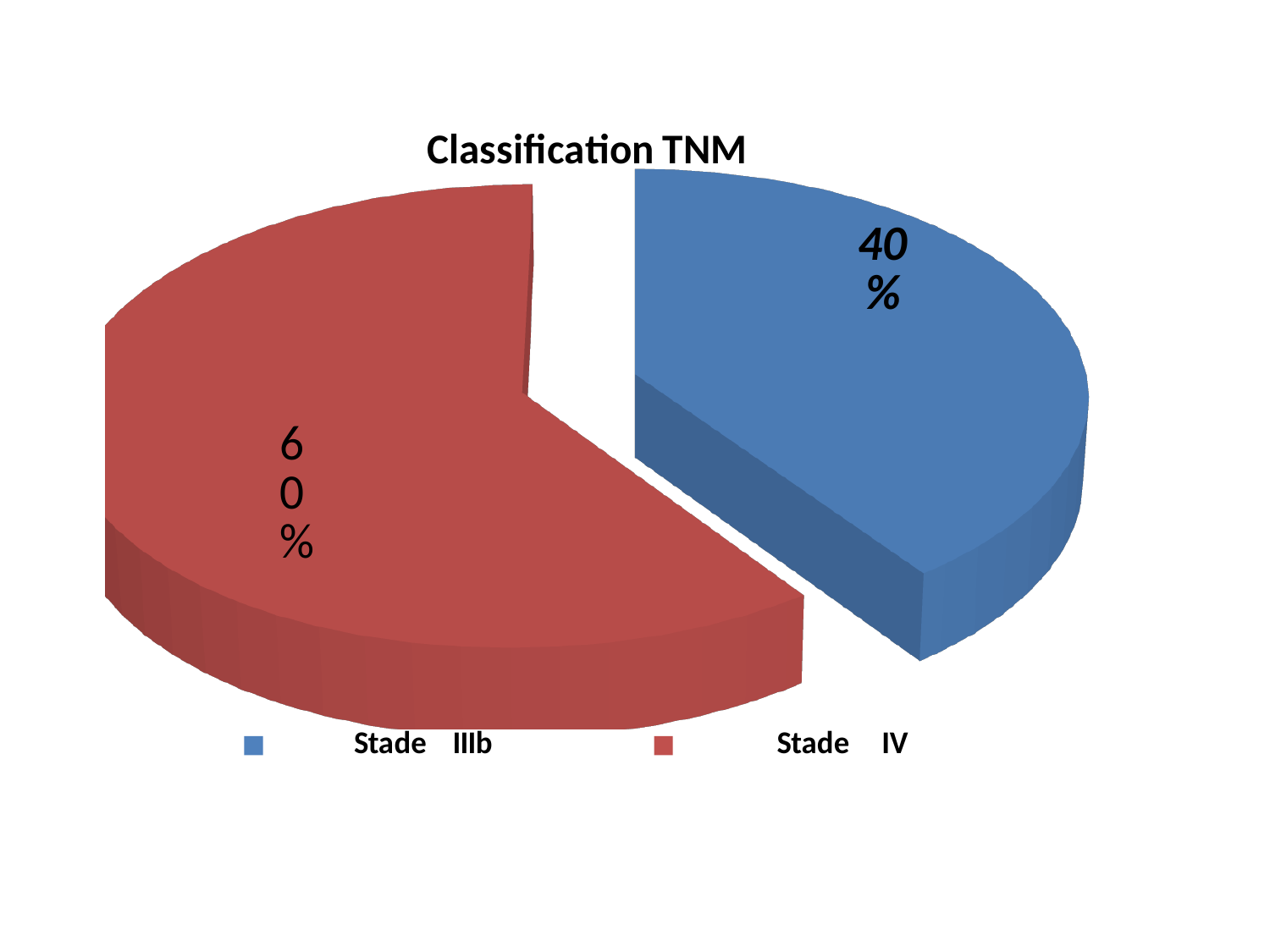
Which category has the smallest slice of the pie? Stade IIIb What kind of chart is shown on the slide? pie chart Which is larger, the share for Stade IIIb or the share for Stade IV? Stade IV Which colour represents Stade IIIb in the legend? blue What share of the pie does Stade IV represent? 60% What is the title of the chart? Classification TNM What is the difference in percentage points between Stade IV and Stade IIIb? 20 What share of the pie does Stade IIIb represent? 40% Which category has the largest slice of the pie? Stade IV Is the share for Stade IV greater or less than 50%? greater How many categories does the pie chart show? 2